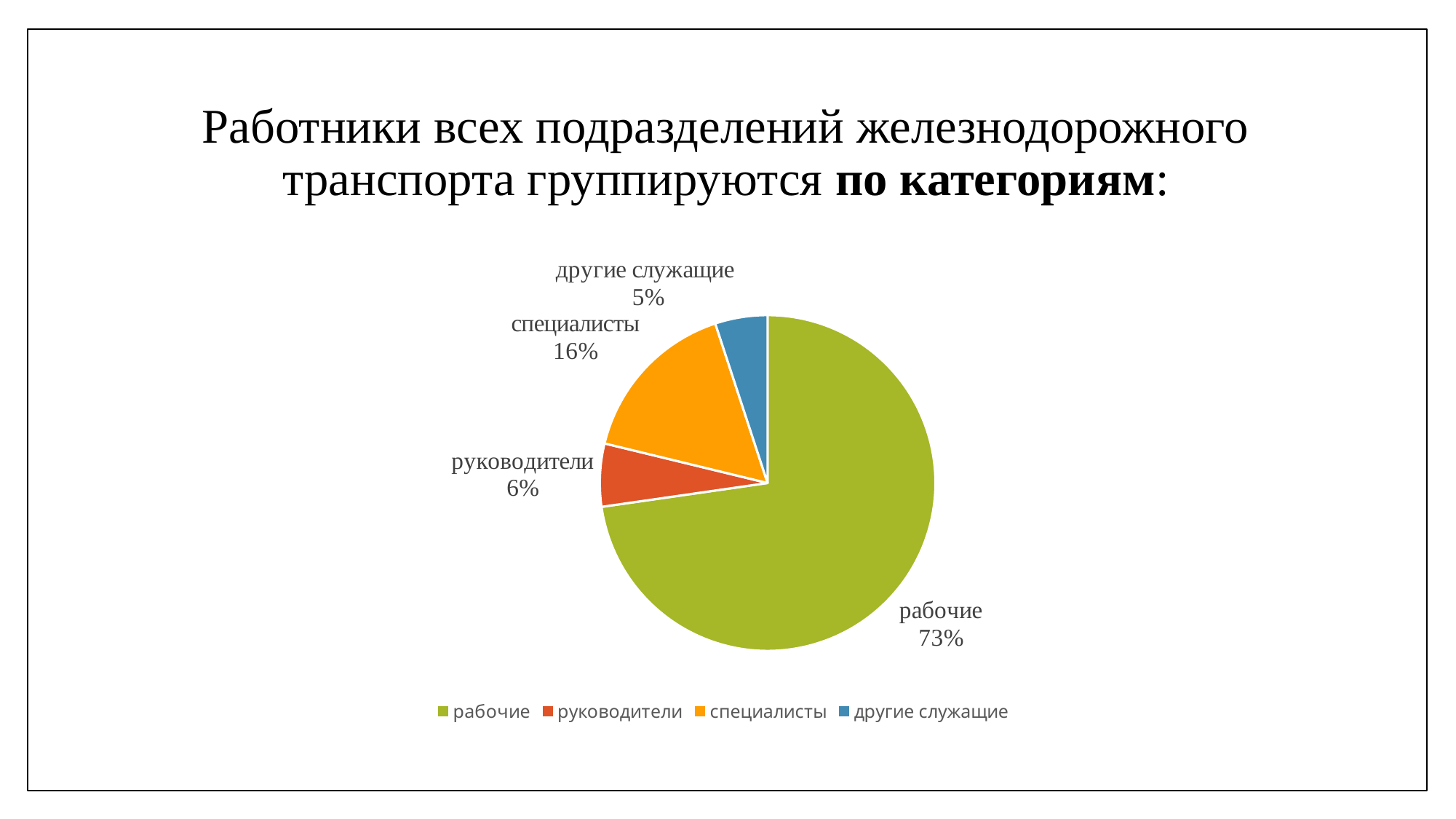
What kind of chart is shown on the slide? pie chart How many categories are shown in the pie chart? 4 What is the difference in percentage points between рабочие and специалисты? 57 What share of the pie does the slice for руководители represent? 6% Which category has the smallest slice of the pie? другие служащие What is the difference in percentage points between специалисты and руководители? 10 Which is larger, the share for специалисты or the share for руководители? специалисты What colour is the slice for специалисты? orange Which category has the largest slice of the pie? рабочие What share of the pie does the slice for специалисты represent? 16% What share of the pie does the slice for другие служащие represent? 5%